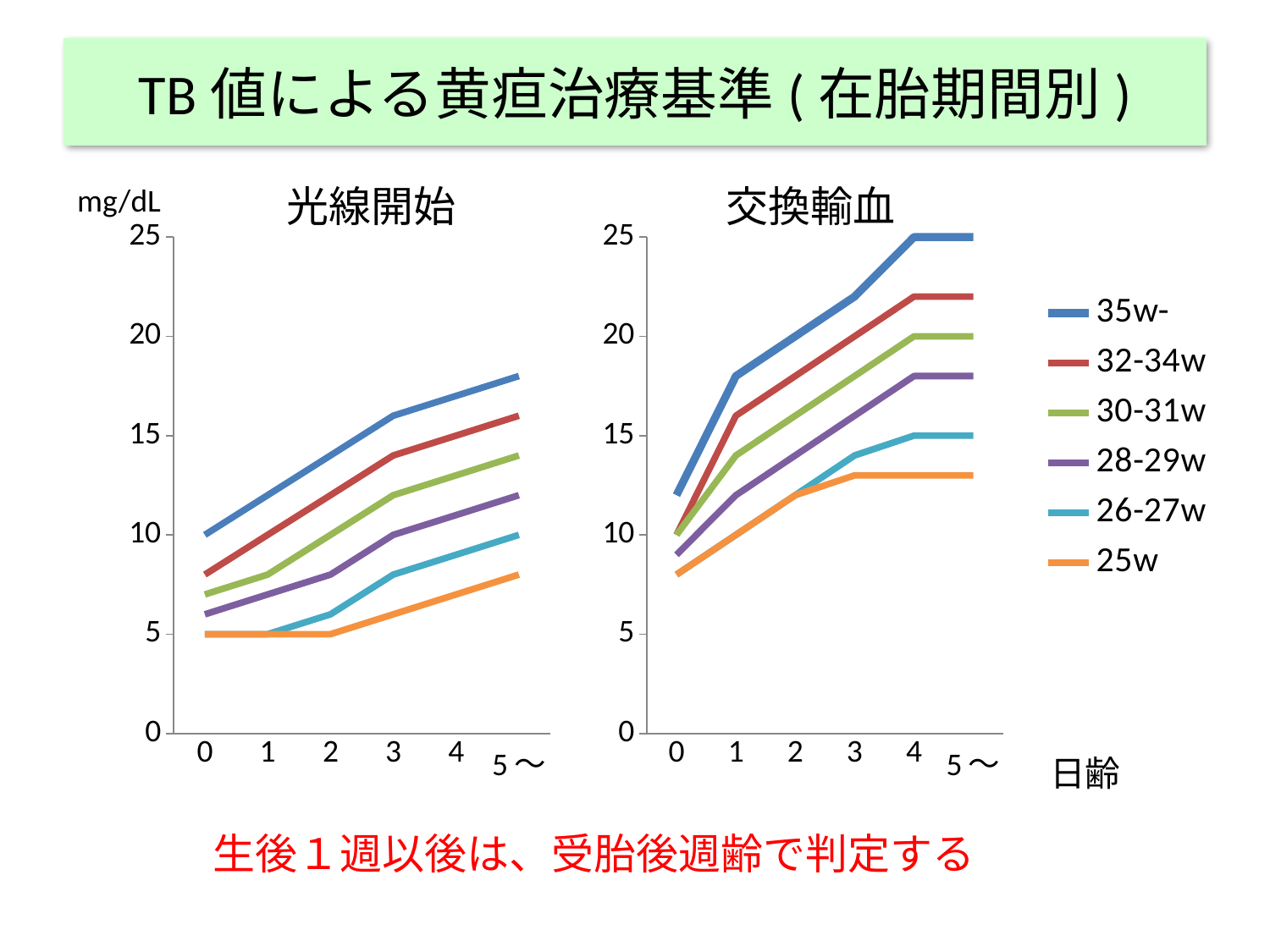
What kind of chart is the 光線開始 chart? line chart How many series does the legend list? 6 In the 交換輸血 chart, what is the value for 35w- at day 4? 25 How many points are on the x axis of the 交換輸血 chart? 6 In the 交換輸血 chart, do the values for 32-34w rise or fall from day 0 to day 4? rise In the 光線開始 chart, what is the value for 35w- at day 0? 10 In the 光線開始 chart, is the value for 35w- at 5〜 greater or less than 15? greater In the 交換輸血 chart, which series is highest at 5〜? 35w- In the 光線開始 chart, what is the value for 25w at day 0? 5 In the 光線開始 chart, which series is lowest at 5〜? 25w In the 交換輸血 chart, what is the value for 30-31w at 5〜? 20 In the 光線開始 chart, at day 3, which is larger: 35w- or 25w? 35w-